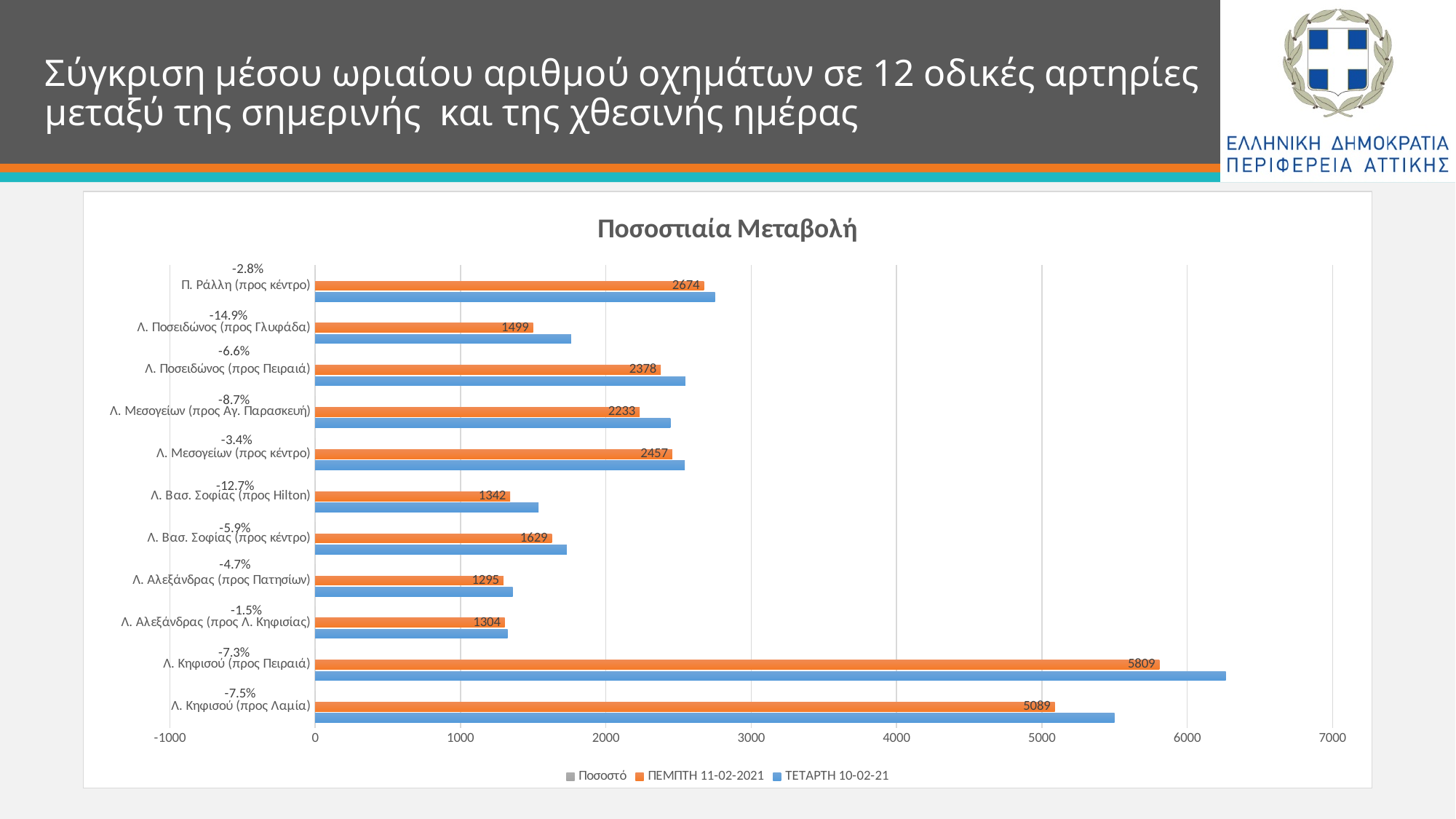
What is the difference between the ΠΕΜΠΤΗ 11-02-2021 values for Λ. Κηφισού (προς Πειραιά) and Λ. Κηφισού (προς Λαμία)? 720 How many roads are listed on the chart? 11 Is the ΤΕΤΑΡΤΗ 10-02-21 value for Λ. Κηφισού (προς Πειραιά) greater or less than 6000? greater Which road has the highest ΠΕΜΠΤΗ 11-02-2021 value? Λ. Κηφισού (προς Πειραιά) How many series does the legend list? 3 What is the ΠΕΜΠΤΗ 11-02-2021 value for Π. Ράλλη (προς κέντρο)? 2674 What percentage change is shown for Λ. Ποσειδώνος (προς Γλυφάδα)? -14.9% Which road has the lowest ΠΕΜΠΤΗ 11-02-2021 value? Λ. Αλεξάνδρας (προς Πατησίων) What type of chart is shown? bar chart Which is larger for ΠΕΜΠΤΗ 11-02-2021: Λ. Μεσογείων (προς κέντρο) or Λ. Μεσογείων (προς Αγ. Παρασκευή)? Λ. Μεσογείων (προς κέντρο) What is the ΠΕΜΠΤΗ 11-02-2021 value for Λ. Κηφισού (προς Λαμία)? 5089 What percentage change is shown for Λ. Αλεξάνδρας (προς Λ. Κηφισίας)? -1.5%